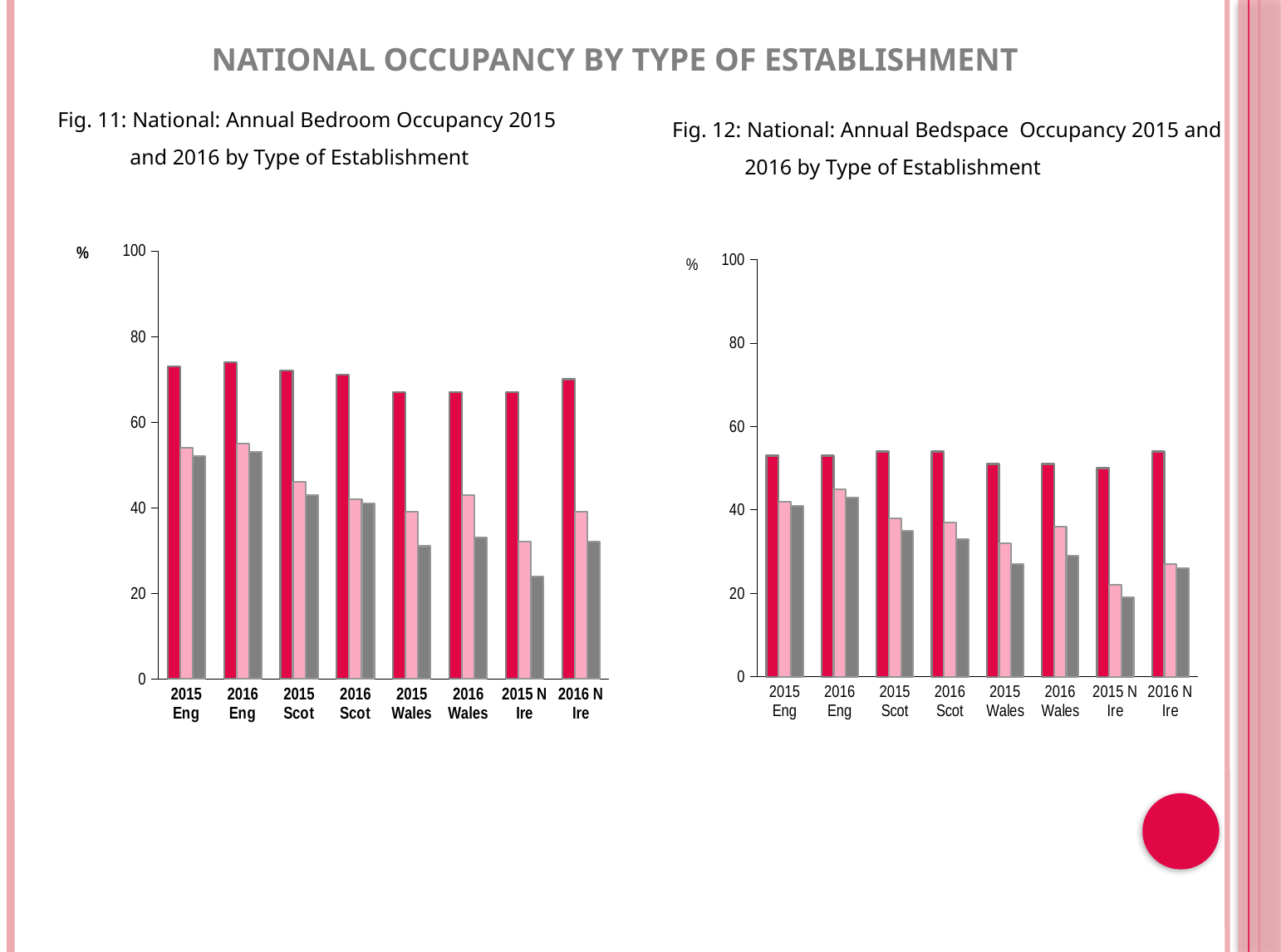
In Fig. 12 (Annual Bedspace Occupancy), which category has the lowest pink bar? 2015 N Ire In Fig. 12 (Annual Bedspace Occupancy), how many categories are shown on the x axis? 8 In Fig. 12 (Annual Bedspace Occupancy), is the grey bar larger for 2016 Eng or for 2016 Wales? 2016 Eng In Fig. 11 (Annual Bedroom Occupancy), is the grey bar for 2015 N Ire greater or less than 40? less In Fig. 11 (Annual Bedroom Occupancy), how many categories are shown on the x axis? 8 In Fig. 11 (Annual Bedroom Occupancy), is the pink bar larger for 2015 Eng or for 2015 Wales? 2015 Eng In Fig. 12 (Annual Bedspace Occupancy), what unit is shown on the y axis? % In Fig. 12 (Annual Bedspace Occupancy), is the red bar for 2015 Wales greater or less than 60? less In Fig. 11 (Annual Bedroom Occupancy), which category has the lowest grey bar? 2015 N Ire In Fig. 12 (Annual Bedspace Occupancy), is the red bar for 2016 Scot greater or less than 40? greater What kind of chart is Fig. 11: National: Annual Bedroom Occupancy 2015 and 2016 by Type of Establishment? bar chart